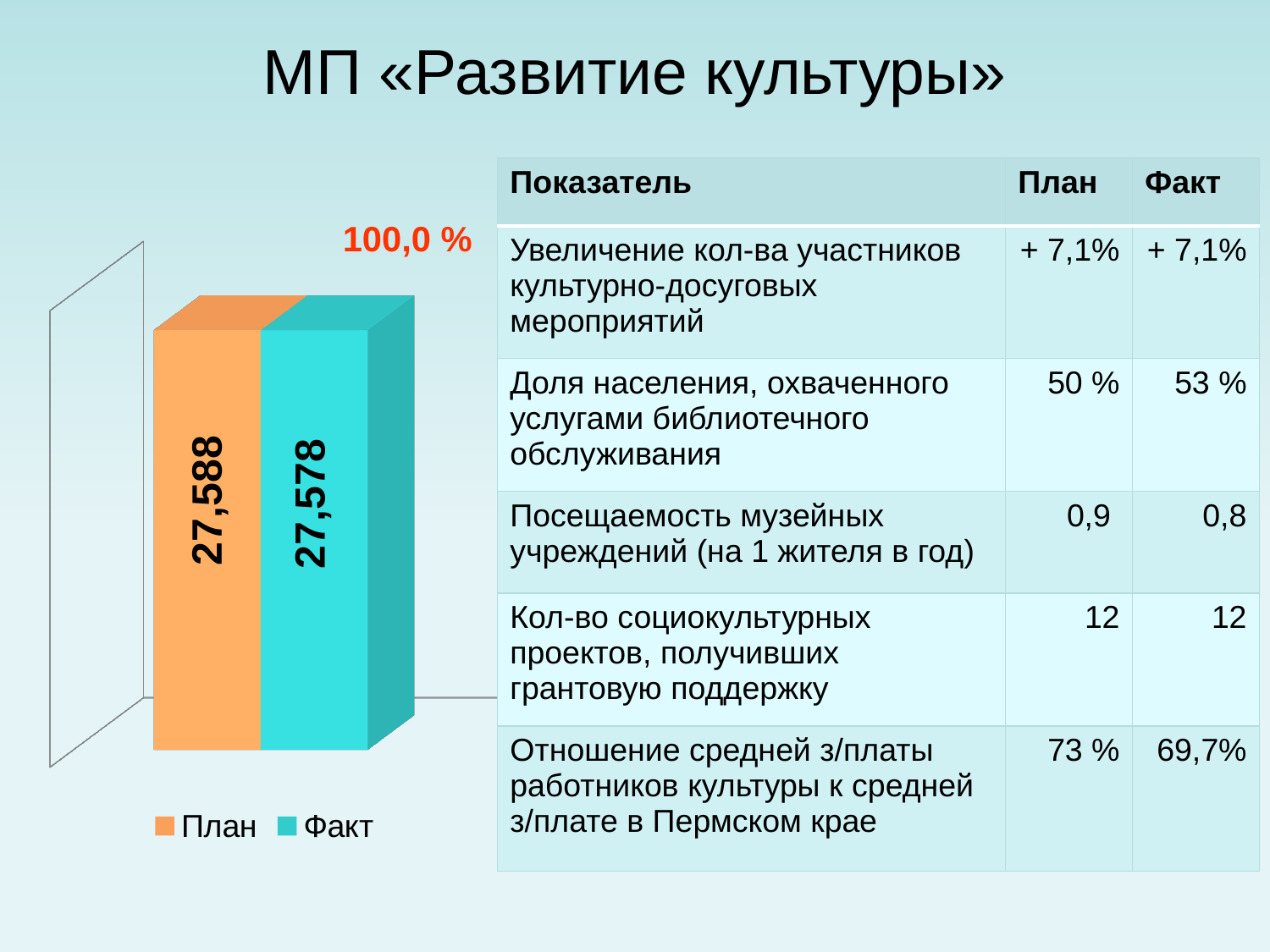
What percentage label is printed above the bars on the chart? 100,0 % How many bars are plotted on the chart? 2 What is the value shown for План on the bar chart? 27,588 Which series has the highest value on the bar chart? План What is the value shown for Факт on the bar chart? 27,578 What kind of chart is shown on the left of the slide? Bar chart What colour is the Факт bar in the chart? Teal Which series has the lowest value on the bar chart? Факт Which bar has the higher value on the chart, План or Факт? План How many series does the chart legend list? 2